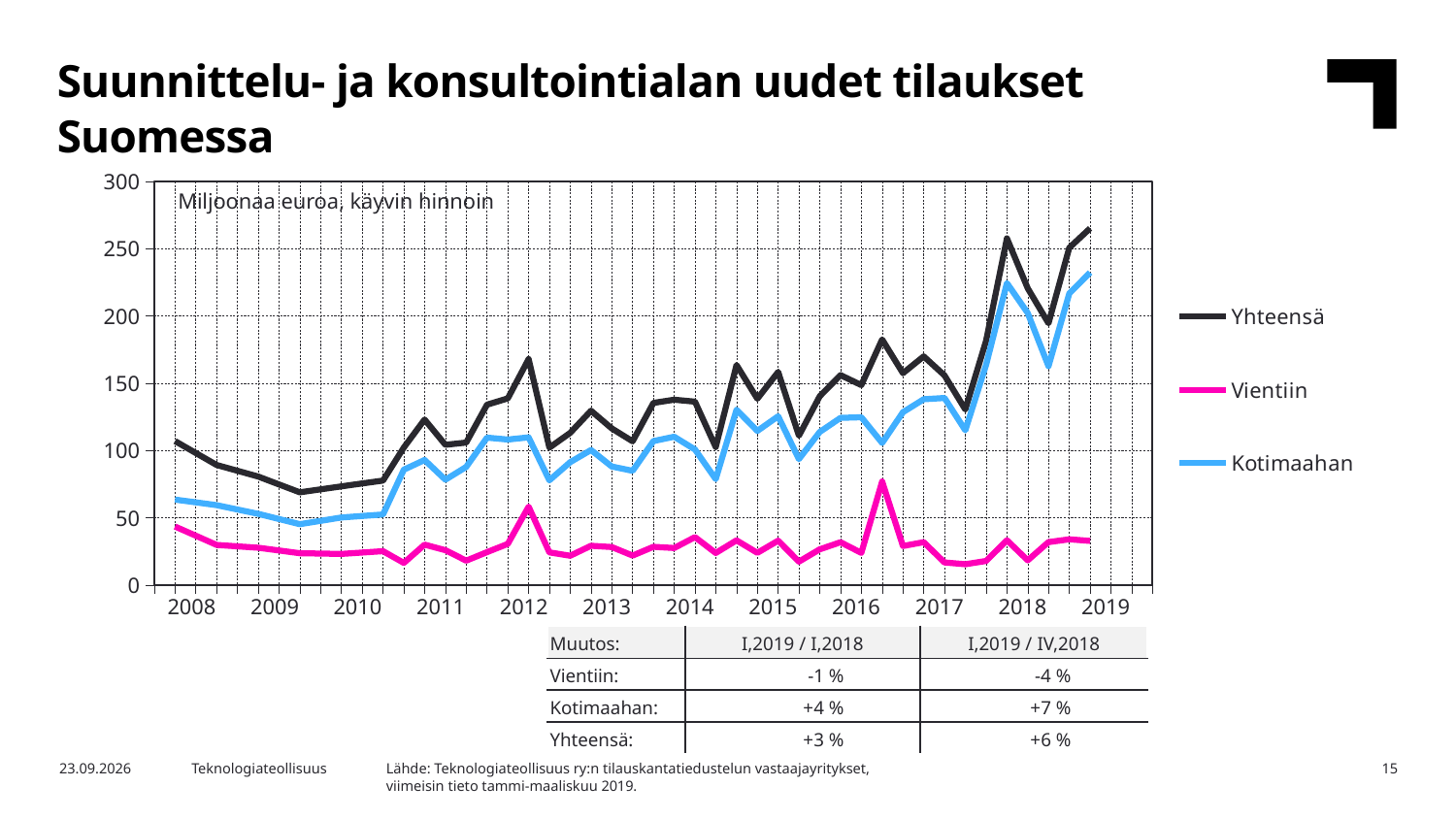
How many years are labelled on the x axis? 12 What kind of chart is shown on the slide? line chart Which is larger in 2012, Kotimaahan or Vientiin? Kotimaahan Is the peak value of Vientiin in 2016 greater or less than 50? greater Which series are listed in the chart legend? Yhteensä, Vientiin, Kotimaahan Is the value of Yhteensä at the last point in 2019 greater or less than 250? greater Which series has the lowest values throughout the chart? Vientiin How many series does the chart legend list? 3 Which series has the highest values throughout the chart? Yhteensä What unit label is shown inside the chart area? Miljoonaa euroa, käyvin hinnoin Is the value of Yhteensä at its low point in 2009 greater or less than 100? less Does the Yhteensä series overall rise or fall from 2008 to 2019? rise